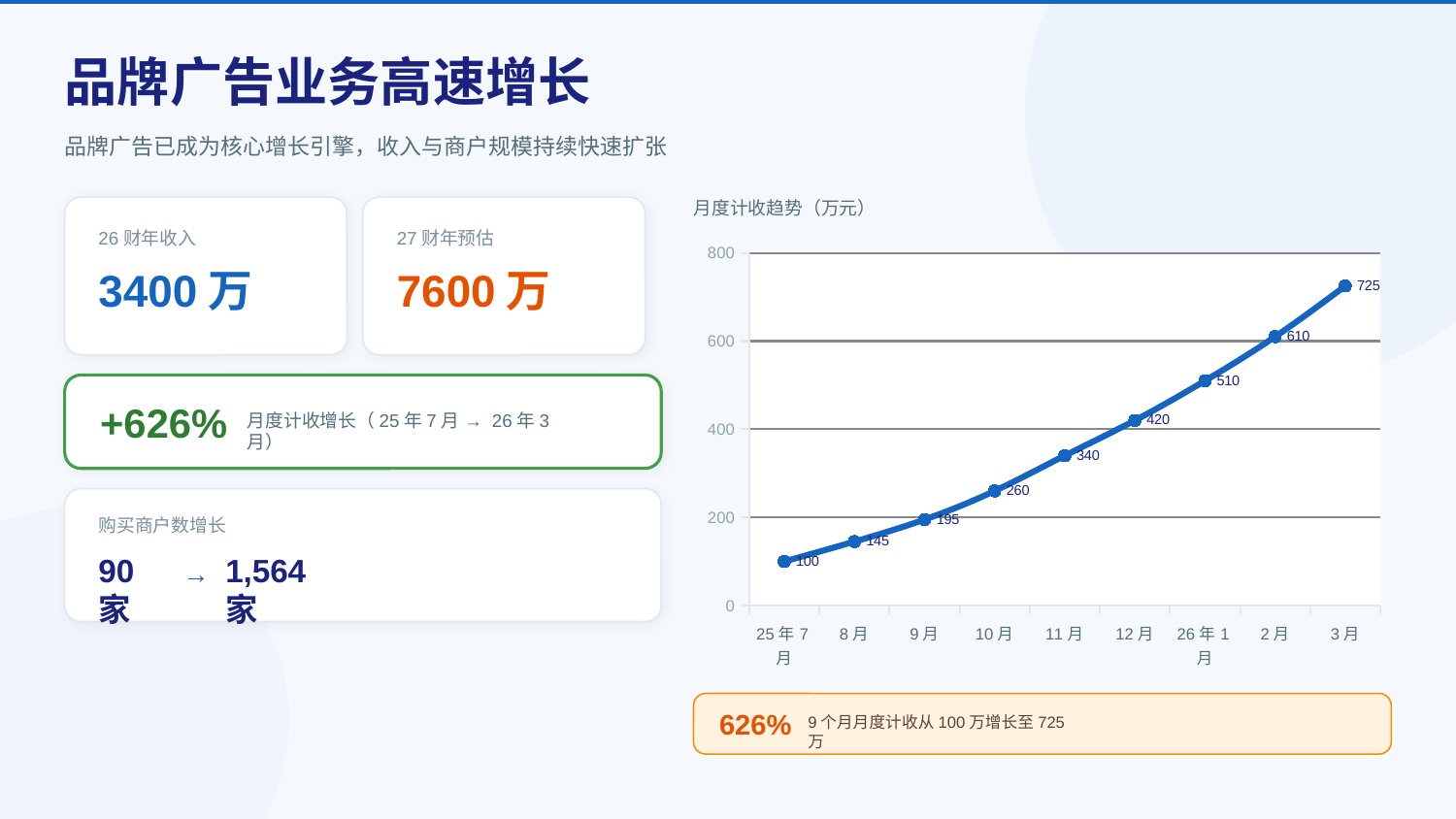
Which month has the lowest value in the 月度计收趋势 chart? 25年7月 How many data points are plotted in the 月度计收趋势 chart? 9 What is the value for 25年7月 in the 月度计收趋势 chart? 100 Do the values in the 月度计收趋势 chart rise or fall from 25年7月 to 3月? rise What is the difference between the values for 12月 and 11月 in the 月度计收趋势 chart? 80 Is the value for 11月 in the 月度计收趋势 chart greater or less than 400? less Which is larger in the 月度计收趋势 chart, the value for 9月 or the value for 2月? 2月 Which month has the highest value in the 月度计收趋势 chart? 3月 What is the difference between the values for 3月 and 25年7月 in the 月度计收趋势 chart? 625 What kind of chart is the 月度计收趋势 chart? line chart What is the value for 10月 in the 月度计收趋势 chart? 260 What is the value for 26年1月 in the 月度计收趋势 chart? 510